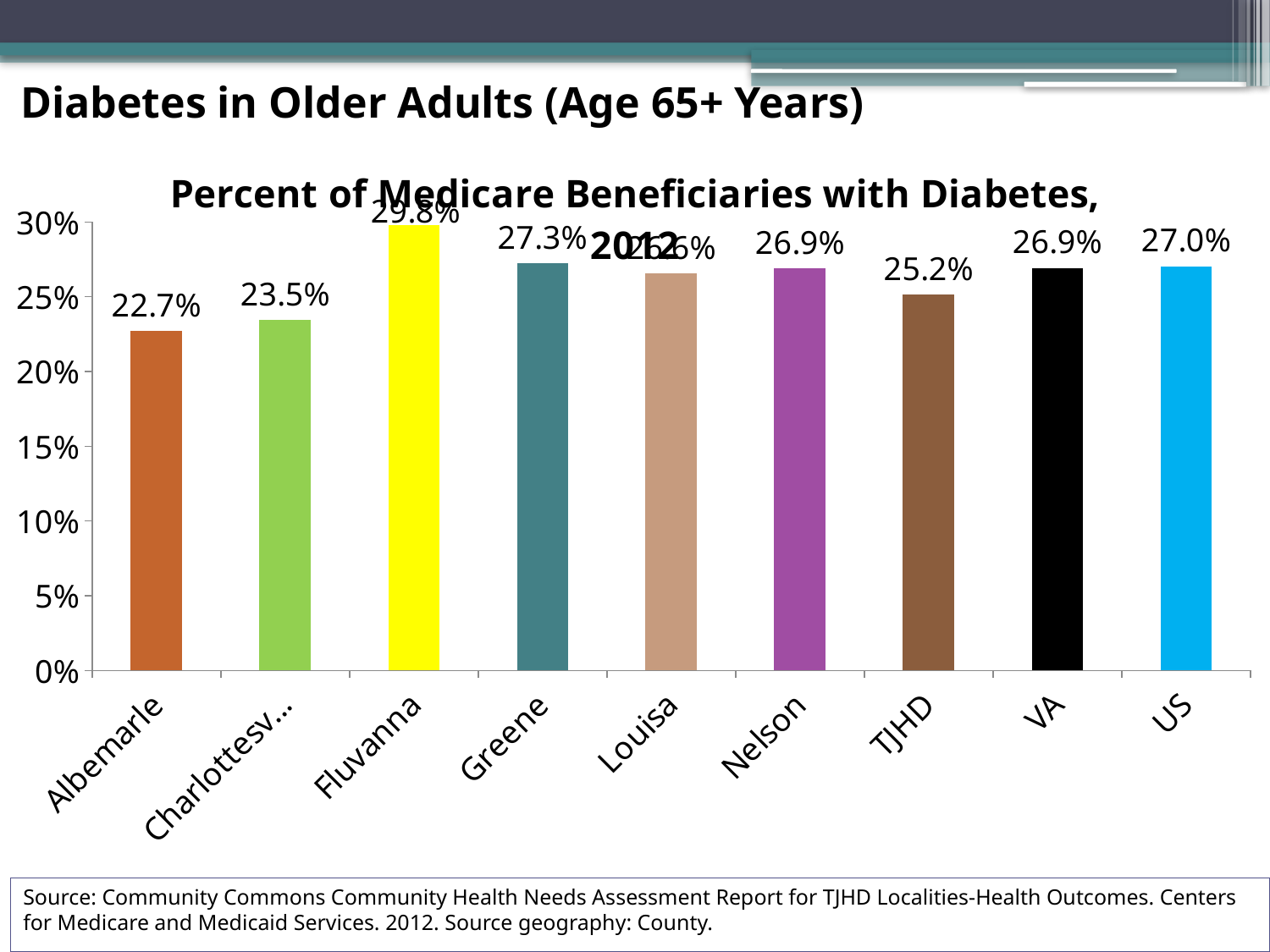
Which category has the lowest value? Albemarle What is the value for Albemarle? 22.7% What is the value for US? 27.0% What is the value for Greene? 27.3% What is the value for TJHD? 25.2% What is the difference between the values for Fluvanna and Albemarle? 7.1 percentage points How many categories are shown on the x axis? 9 Is the value for Albemarle greater or less than 25%? less Which category has the highest value? Fluvanna What kind of chart is shown on the slide? bar chart What is the value for Fluvanna? 29.8% Which is larger, the value for Greene or the value for TJHD? Greene